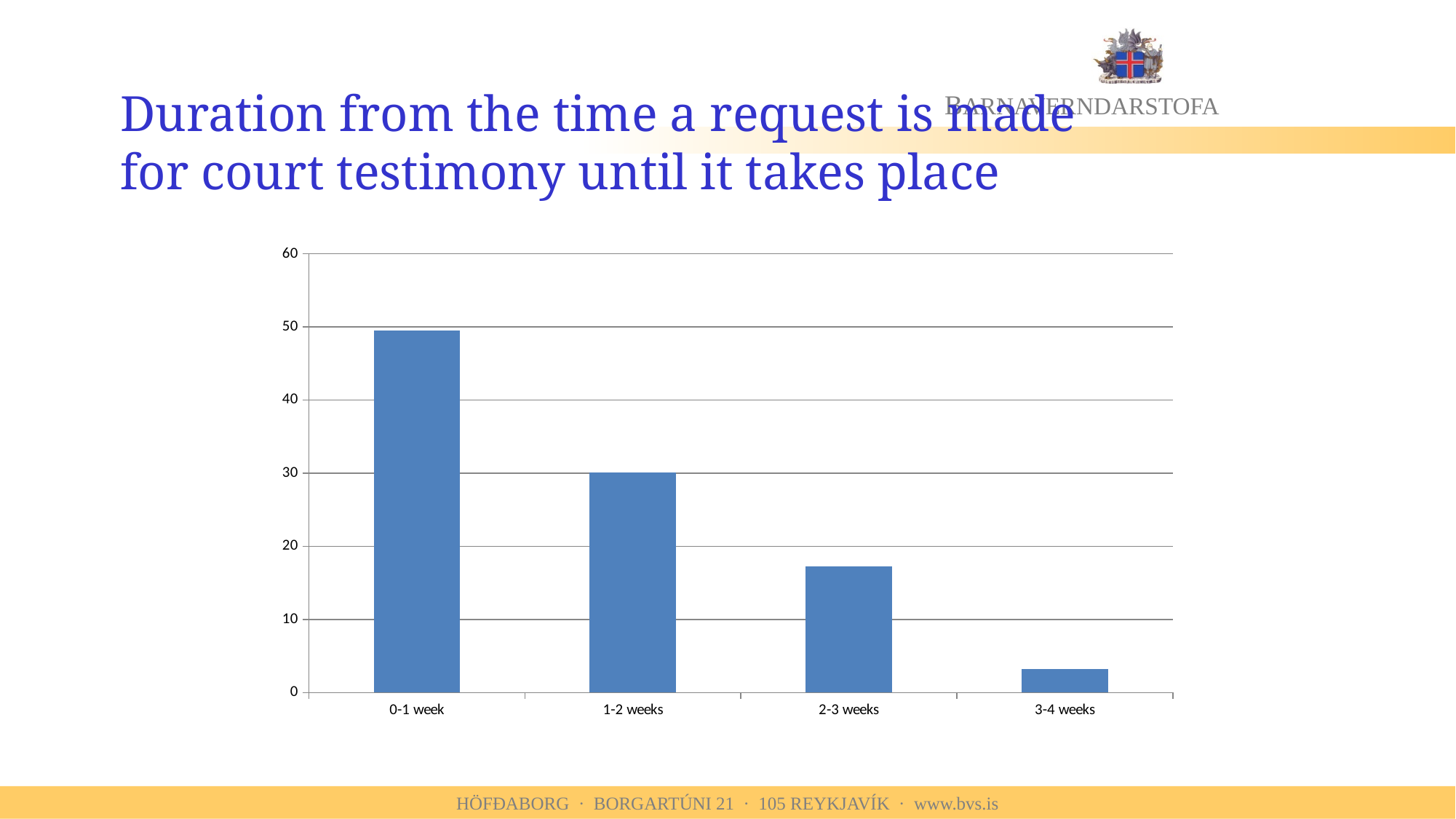
What is the highest value shown on the y axis of the chart? 60 What kind of chart is shown on the slide? bar chart Which is larger, the value for 1-2 weeks or the value for 2-3 weeks? 1-2 weeks Which category has the highest bar? 0-1 week Is the value for 3-4 weeks greater or less than 10? less Is the value for 0-1 week greater or less than 40? greater Do the values rise or fall as you move from 0-1 week to 3-4 weeks along the x axis? fall Which category has the lowest bar? 3-4 weeks Is the value for 2-3 weeks greater or less than 20? less What is the title of the slide containing the chart? Duration from the time a request is made for court testimony until it takes place How many categories are shown on the x axis of the chart? 4